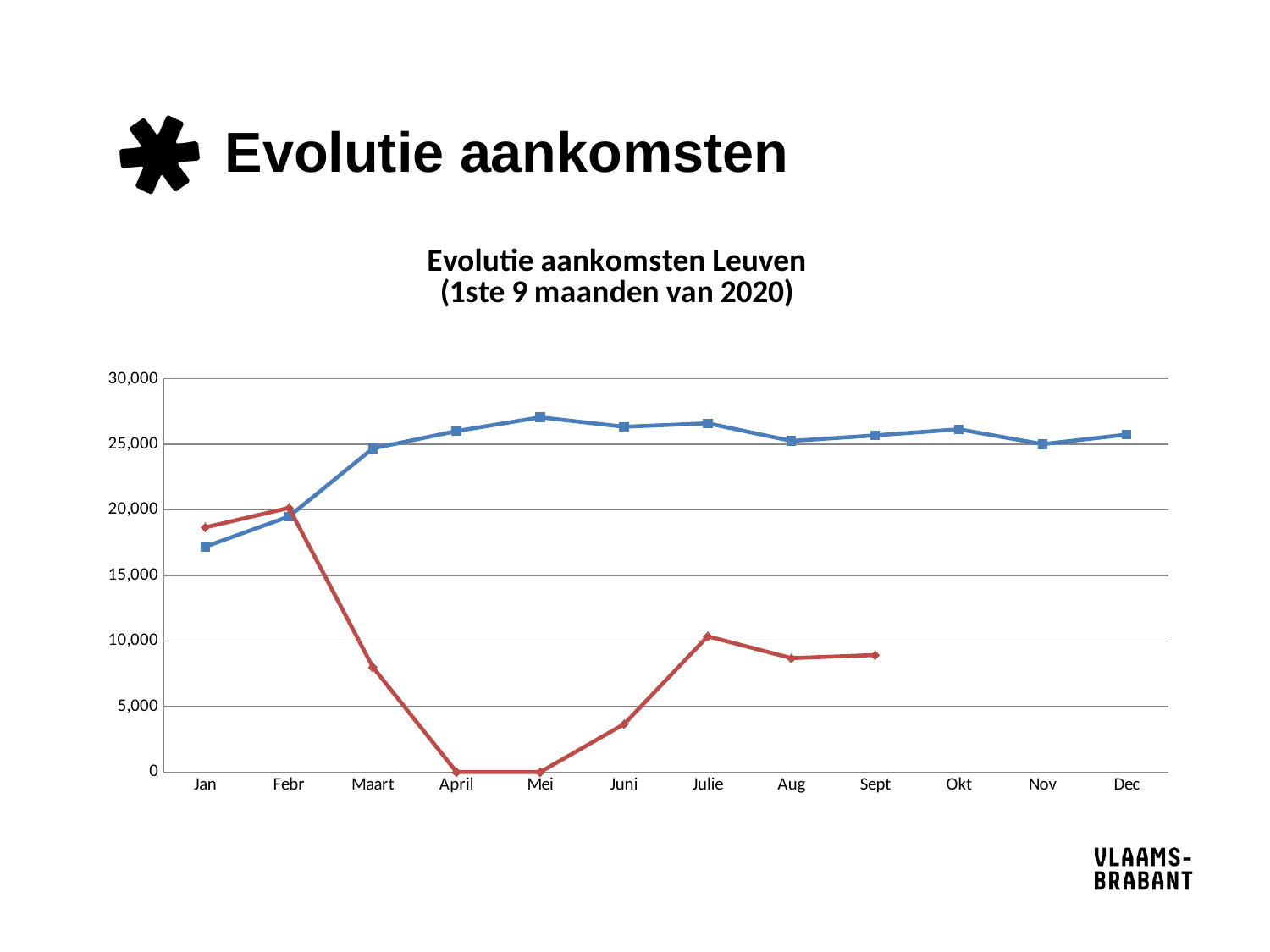
In which month does the blue line reach its highest value? Mei What is the last month for which the red line has a data point? Sept Does the red line rise or fall from Febr to April? fall What is the title of the chart? Evolutie aankomsten Leuven (1ste 9 maanden van 2020) What kind of chart is shown on the slide? line chart Is the value of the red line in April greater or less than 5,000? less In which month does the blue line have its lowest value? Jan How many months are shown on the x axis of the chart? 12 Is the value of the red line in Maart greater or less than 10,000? less In Jan, which line is higher, the red line or the blue line? red line How many data points does the red line have? 9 Is the value of the blue line in Mei greater or less than 25,000? greater